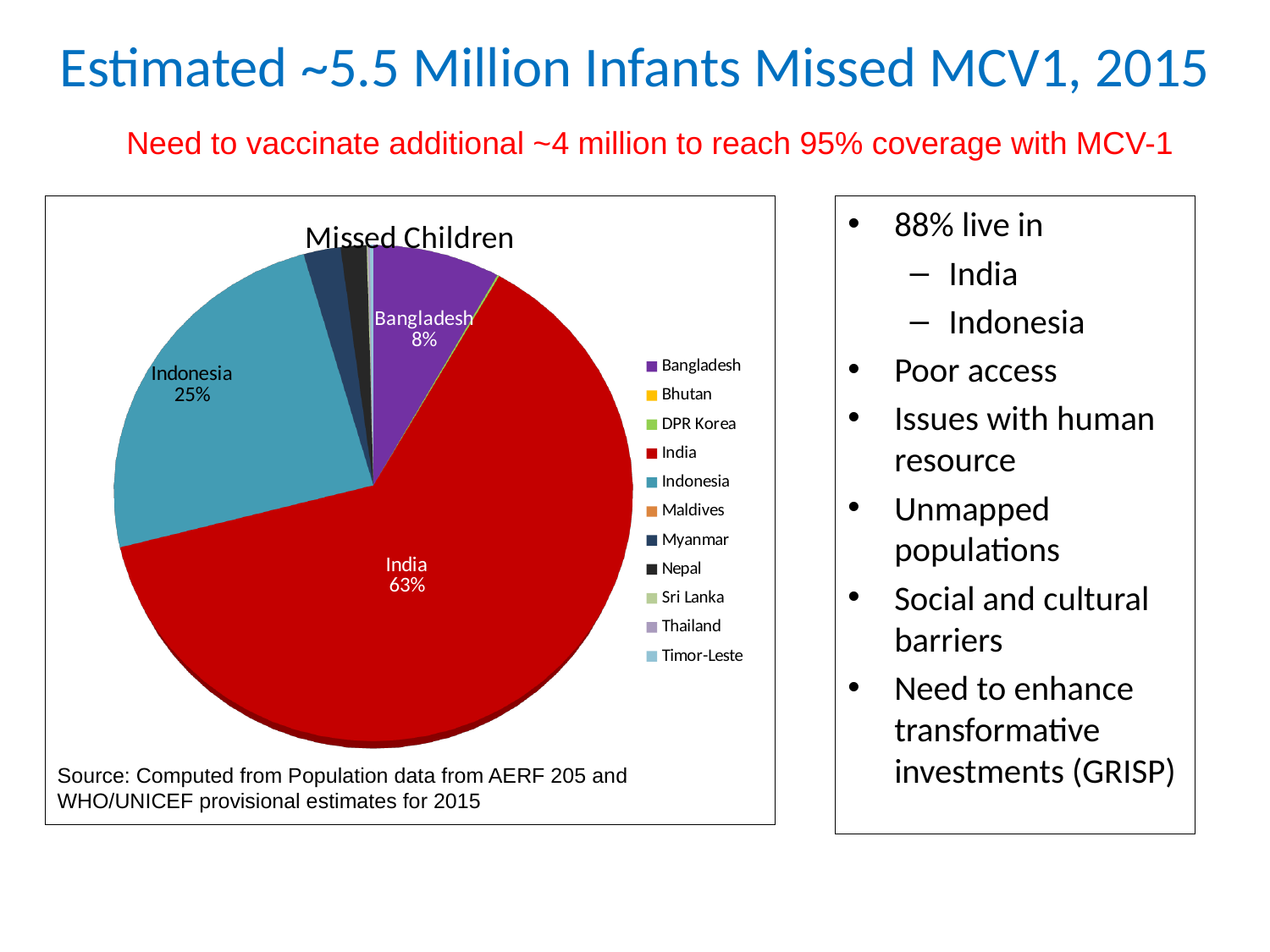
What kind of chart is shown on the slide? pie chart What is the difference in percentage points between India's share and Indonesia's share? 38 How many countries are listed in the chart's legend? 11 What is the title of the chart? Missed Children What is the combined share of India and Indonesia? 88% Which country has the largest slice of the pie? India What share of missed children does India account for? 63% What share of missed children does Bangladesh account for? 8% What colour is the India slice of the pie? red Is India's share greater or less than 50%? greater What share of missed children does Indonesia account for? 25% Which has a larger share of missed children, Indonesia or Bangladesh? Indonesia